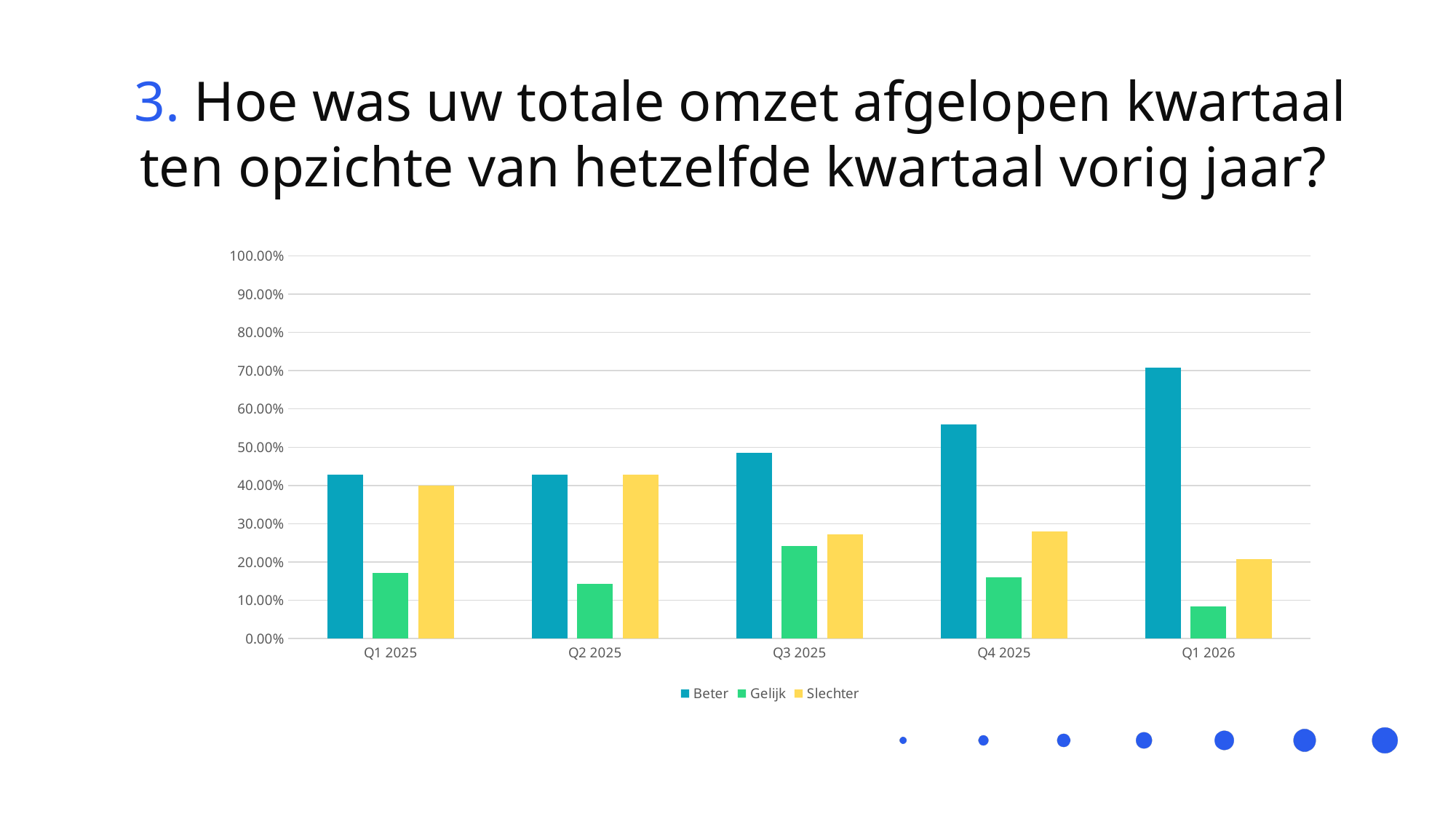
Is the value for Gelijk in Q1 2025 greater or less than 20.00%? less How many series does the chart's legend list? 3 Is the value for Slechter in Q3 2025 greater or less than 30.00%? less How many quarters are shown on the x axis of the chart? 5 Does the value for Beter rise or fall from Q1 2025 to Q1 2026? rises In Q1 2026, which is larger: Gelijk or Slechter? Slechter In which quarter is the value for Gelijk the lowest? Q1 2026 What kind of chart is shown on the slide? bar chart Is the value for Beter in Q1 2026 greater or less than 60.00%? greater In which quarter is the value for Beter the highest? Q1 2026 In Q4 2025, which is larger: Beter or Slechter? Beter